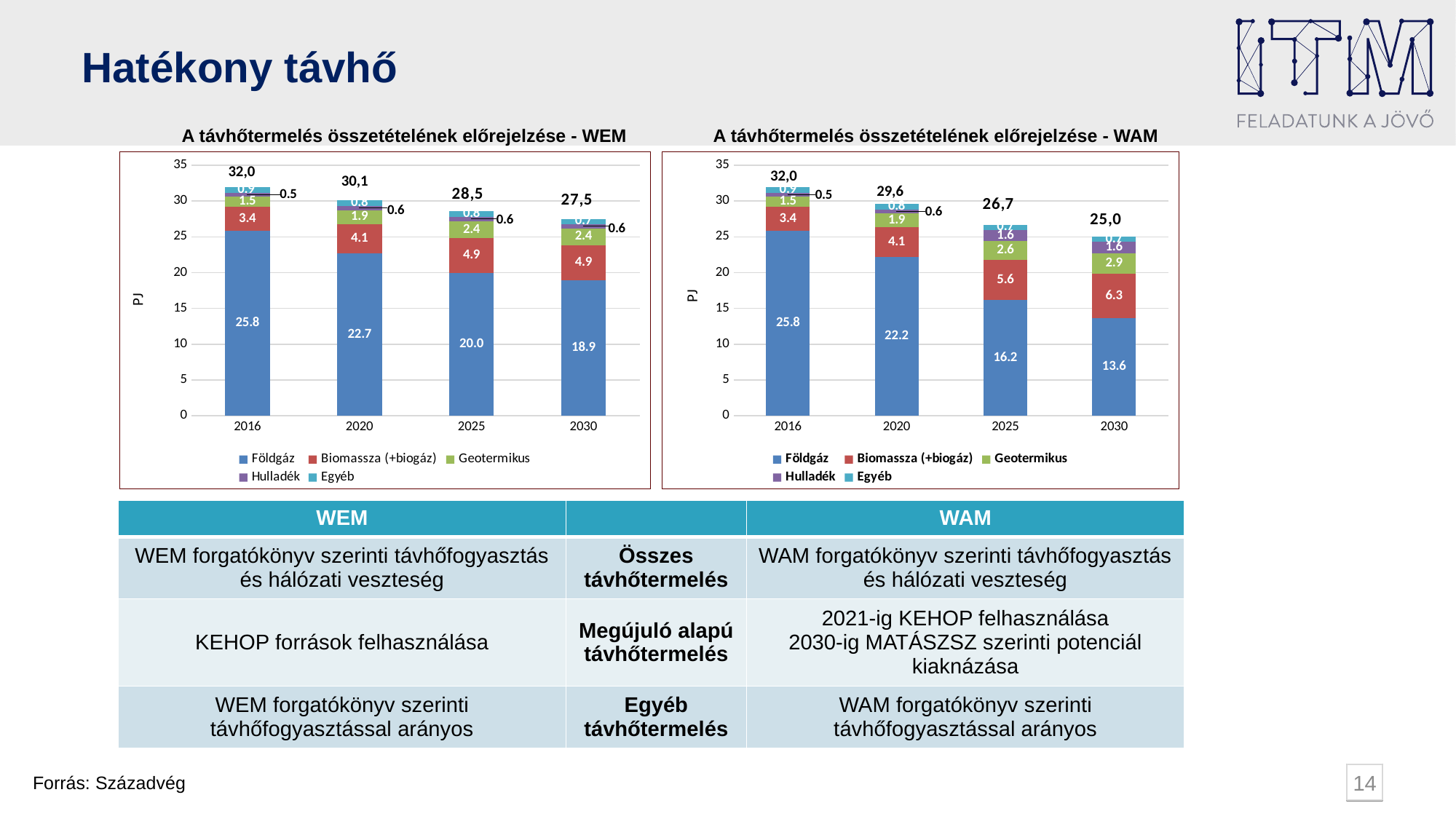
In the WEM chart (left), what is the Földgáz value for 2030? 18.9 How many years are shown on the x axis of the WEM chart (left)? 4 Which chart shows the larger Biomassza (+biogáz) value for 2030, WEM or WAM? WAM In the WEM chart (left), do the bar totals rise or fall from 2016 to 2030? Fall In the WEM chart (left), which year has the highest Földgáz value? 2016 In the WAM chart (right), what is the Földgáz value for 2030? 13.6 In the WEM chart (left), what is the Biomassza (+biogáz) value for 2025? 4.9 In the WAM chart (right), which year has the lowest total? 2030 What kind of chart is the WAM chart (right)? Stacked bar chart In the WEM chart (left), what is the difference between the Földgáz values for 2016 and 2030? 6.9 In the WAM chart (right), what is the total shown above the 2025 bar? 26,7 How many series does the legend of the WAM chart (right) list? 5